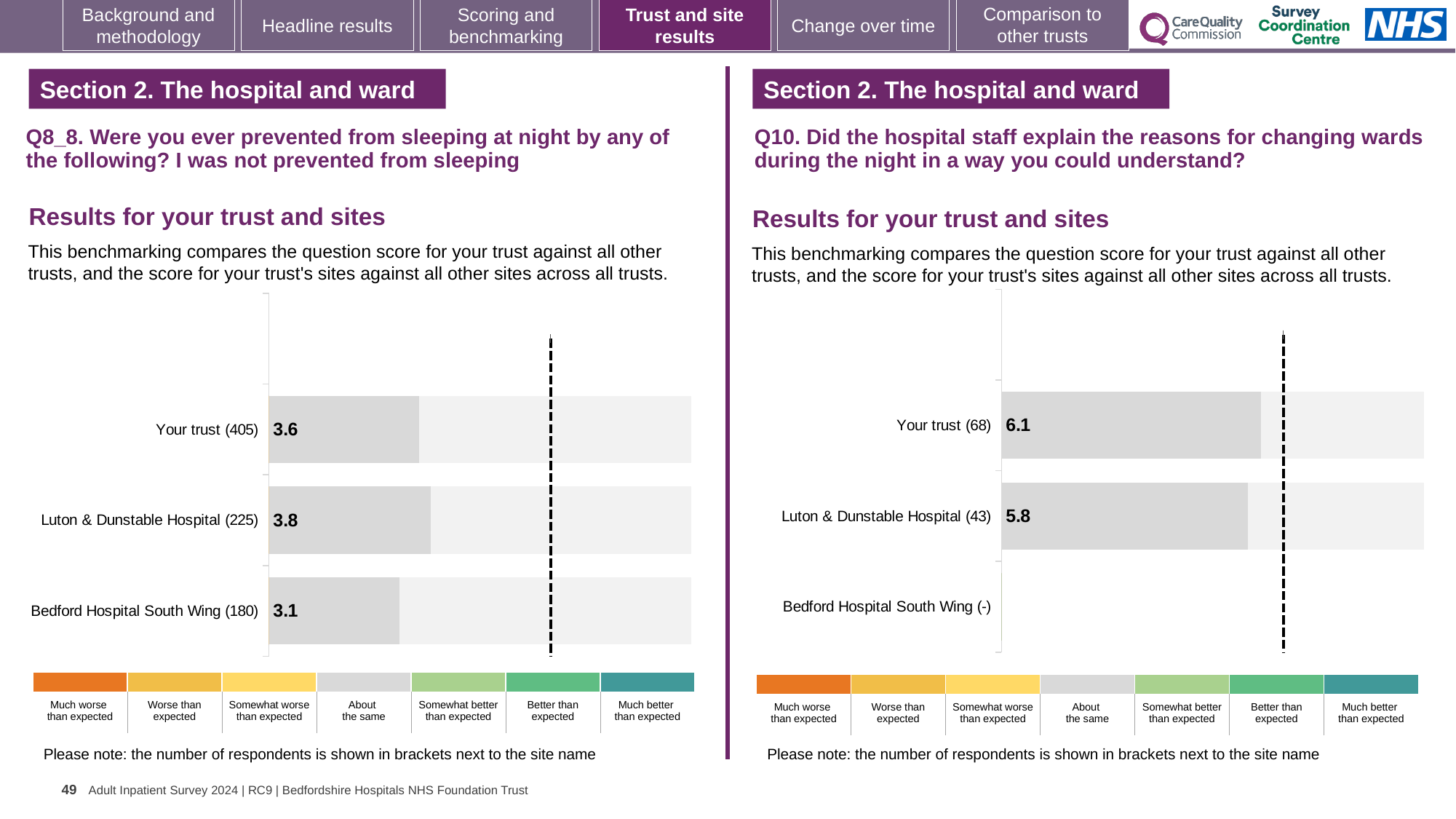
In the Q10 chart on the right, which is larger, the score for Your trust or for Luton & Dunstable Hospital? Your trust In the Q8_8 chart on the left, what is the score for Your trust? 3.6 In the Q10 chart on the right, what is the difference between the scores for Your trust and Luton & Dunstable Hospital? 0.3 In the Q8_8 chart on the left, which site or trust has the lowest score? Bedford Hospital South Wing In the Q8_8 chart on the left, what is the score for Bedford Hospital South Wing? 3.1 How many respondents are shown in brackets for Your trust in the Q8_8 chart on the left? 405 In the Q8_8 chart on the left, which site or trust has the highest score? Luton & Dunstable Hospital What kind of chart is used in the Q8_8 chart on the left? Bar chart In the Q8_8 chart on the left, what is the difference between the scores for Luton & Dunstable Hospital and Bedford Hospital South Wing? 0.7 In the Q10 chart on the right, what is the score for Your trust? 6.1 In the Q8_8 chart on the left, what is the score for Luton & Dunstable Hospital? 3.8 In the Q10 chart on the right, what is the score for Luton & Dunstable Hospital? 5.8